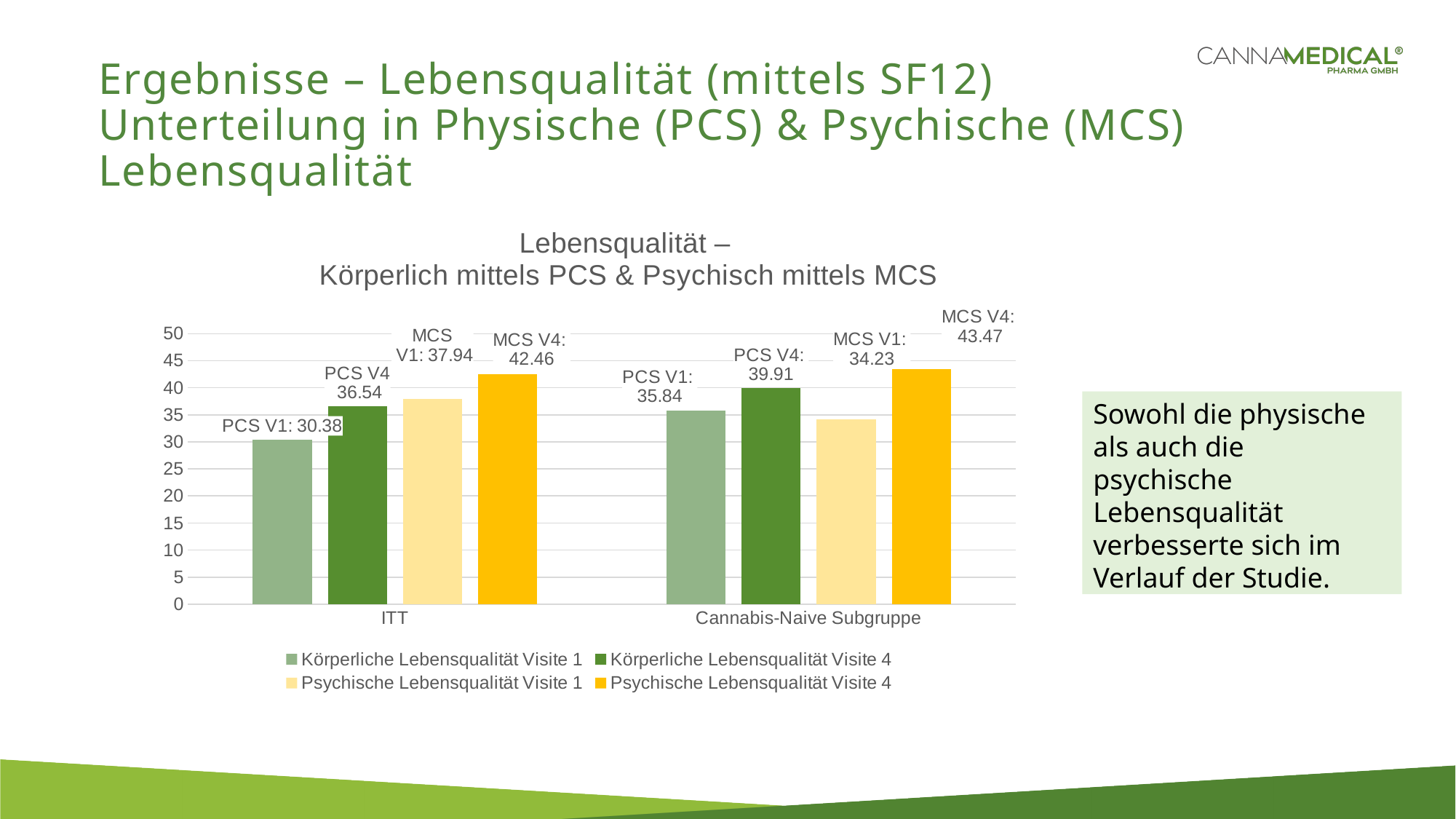
What is the value of Körperliche Lebensqualität Visite 4 (PCS V4) for the Cannabis-Naive Subgruppe? 39.91 Which series has the highest value in the ITT group? Psychische Lebensqualität Visite 4 What is the value of Körperliche Lebensqualität Visite 1 (PCS V1) for ITT? 30.38 What type of chart is shown on the slide? bar chart Which is larger: MCS V4 for ITT or MCS V4 for the Cannabis-Naive Subgruppe? Cannabis-Naive Subgruppe What is the difference between PCS V4 and PCS V1 in the ITT group? 6.16 What is the value of Psychische Lebensqualität Visite 4 (MCS V4) for the Cannabis-Naive Subgruppe? 43.47 Which series has the lowest value in the Cannabis-Naive Subgruppe? Psychische Lebensqualität Visite 1 How many series does the legend list? 4 What is the title of the chart? Lebensqualität – Körperlich mittels PCS & Psychisch mittels MCS What is the value of Psychische Lebensqualität Visite 1 (MCS V1) for ITT? 37.94 How many categories are shown on the x axis? 2